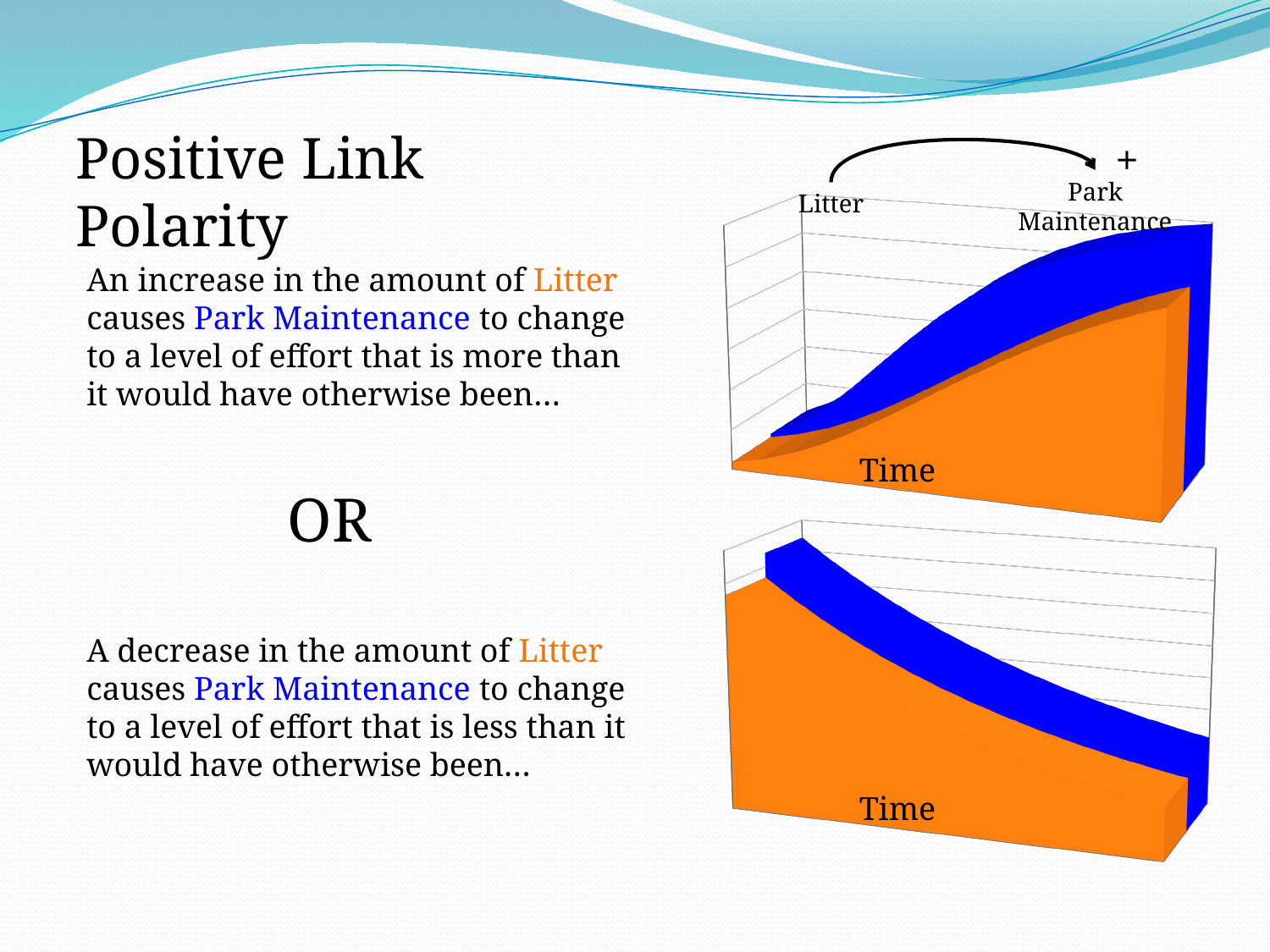
In the bottom chart, do the values rise or fall along the x axis? fall What is the x-axis label of the top chart? Time What two colours are the plotted areas in the bottom chart? orange and blue What kind of chart is the top chart on the right of the slide? area chart What kind of chart is the bottom chart on the right of the slide? area chart In the top chart, do the values rise or fall along the x axis? rise